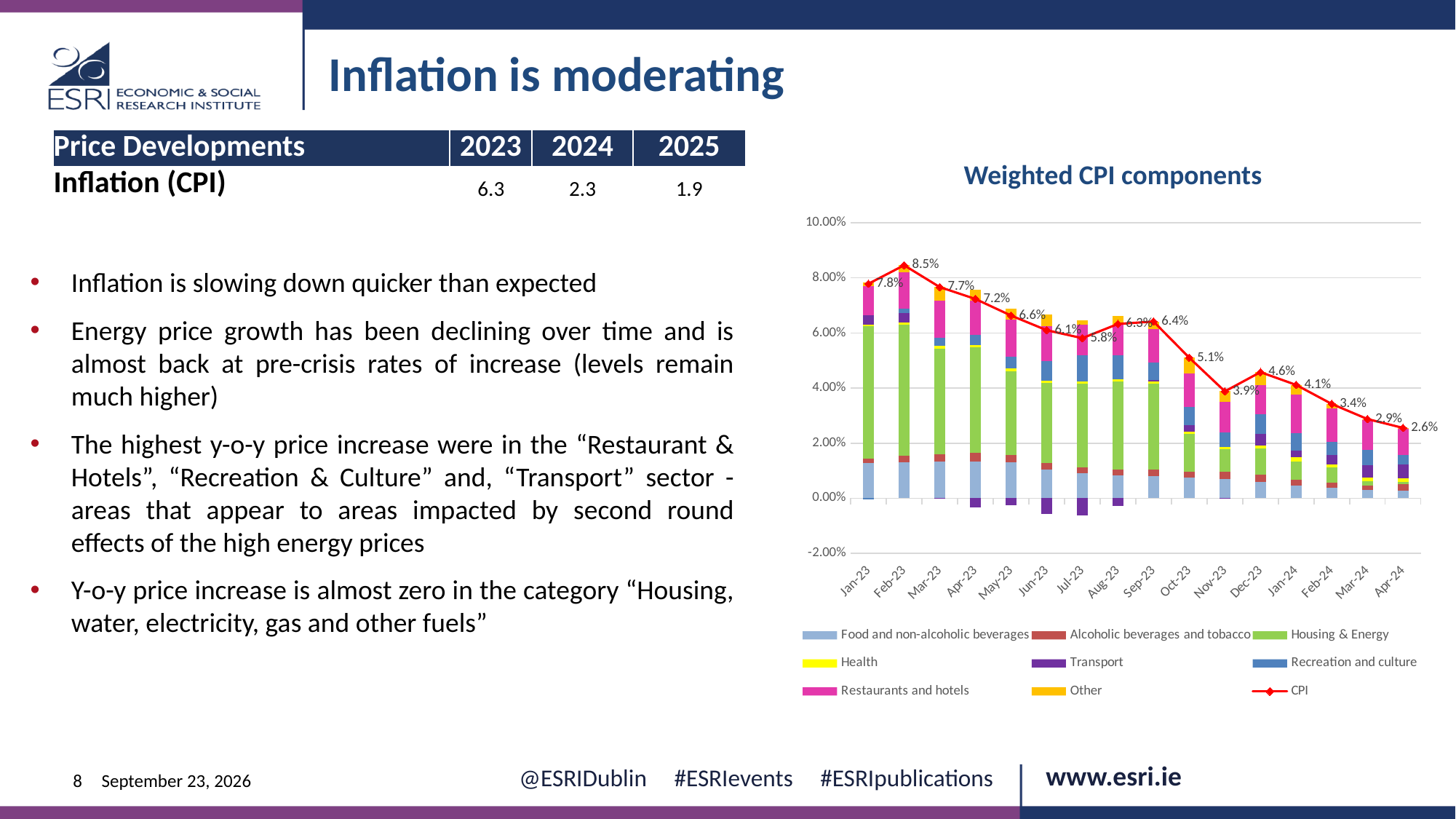
Which month has a higher CPI value, Nov-23 or Dec-23? Dec-23 In which month is the CPI line lowest in the Weighted CPI components chart? Apr-24 Does the CPI line generally rise or fall from Jan-23 to Apr-24? Fall Is the CPI value for Jan-24 greater or less than 6.00%? less In which month is the CPI line highest in the Weighted CPI components chart? Feb-23 What is the CPI value for Feb-23 in the Weighted CPI components chart? 8.5% What is the CPI value for Apr-24 in the Weighted CPI components chart? 2.6% What kind of chart is the Weighted CPI components chart? Stacked bar chart with a line What is the CPI value for Oct-23 in the Weighted CPI components chart? 5.1% How many entries does the legend of the Weighted CPI components chart list? 9 How many months are shown on the x axis of the Weighted CPI components chart? 16 What is the difference between the CPI values for Feb-23 and Apr-24? 5.9%